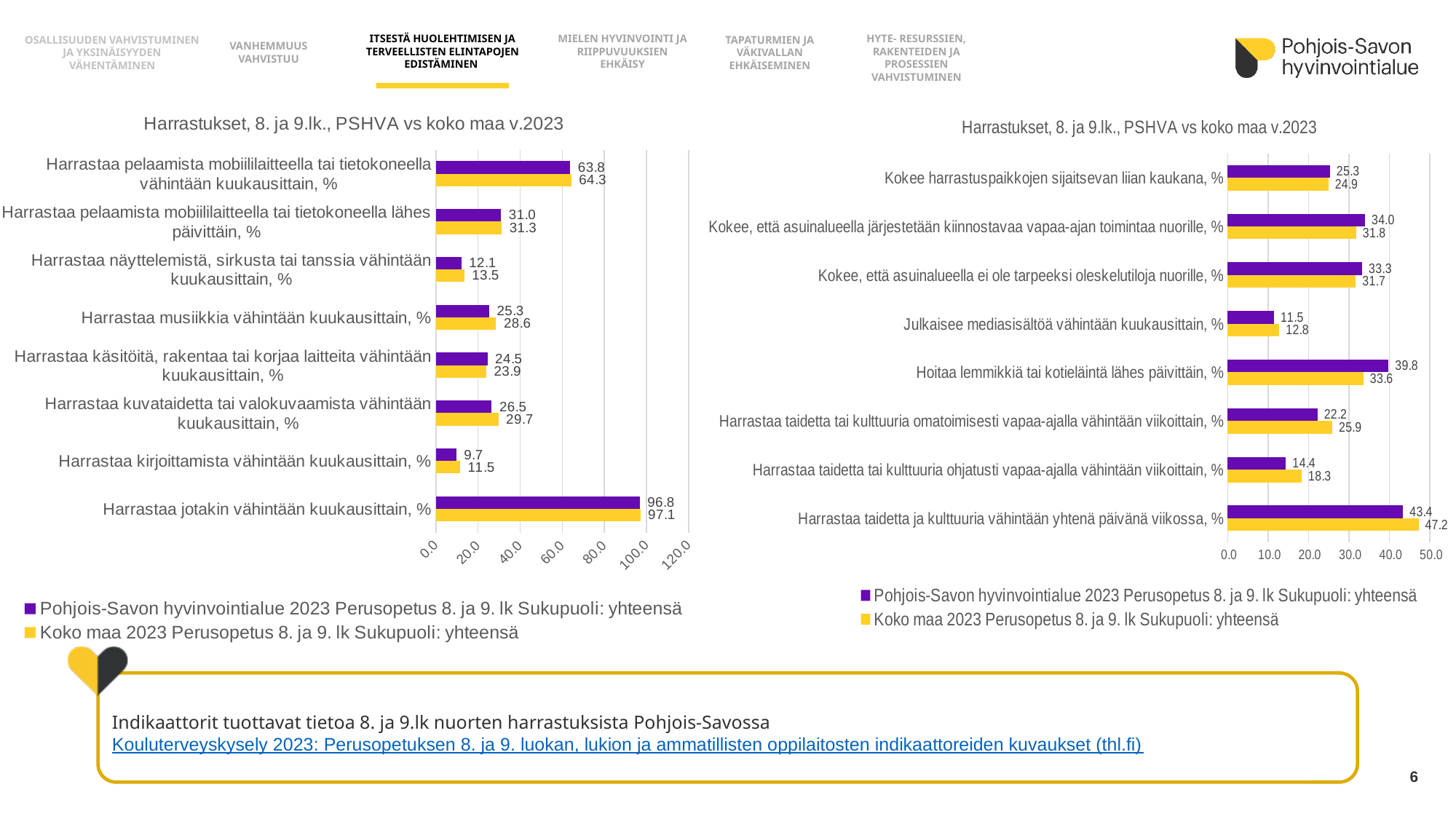
In the left chart, what is the Koko maa value for 'Harrastaa musiikkia vähintään kuukausittain, %'? 28.6 In the left chart, what is the difference between the Koko maa and Pohjois-Savon hyvinvointialue values for 'Harrastaa kuvataidetta tai valokuvaamista vähintään kuukausittain, %'? 3.2 In the left chart, which category has the lowest value for Pohjois-Savon hyvinvointialue? Harrastaa kirjoittamista vähintään kuukausittain, % How many series does the legend of the right chart list? 2 What type of chart is the left chart? Bar chart In the right chart, what is the Pohjois-Savon hyvinvointialue value for 'Hoitaa lemmikkiä tai kotieläintä lähes päivittäin, %'? 39.8 In the right chart, for 'Julkaisee mediasisältöä vähintään kuukausittain, %', which series has the larger value: Pohjois-Savon hyvinvointialue or Koko maa? Koko maa In the right chart, what is the Koko maa value for 'Harrastaa taidetta tai kulttuuria ohjatusti vapaa-ajalla vähintään viikoittain, %'? 18.3 In the left chart, what is the value for Pohjois-Savon hyvinvointialue for 'Harrastaa jotakin vähintään kuukausittain, %'? 96.8 In the right chart, which category has the highest Koko maa value? Harrastaa taidetta ja kulttuuria vähintään yhtenä päivänä viikossa, % In the right chart, what is the difference between the Pohjois-Savon hyvinvointialue and Koko maa values for 'Hoitaa lemmikkiä tai kotieläintä lähes päivittäin, %'? 6.2 In the left chart, how many categories are shown? 8